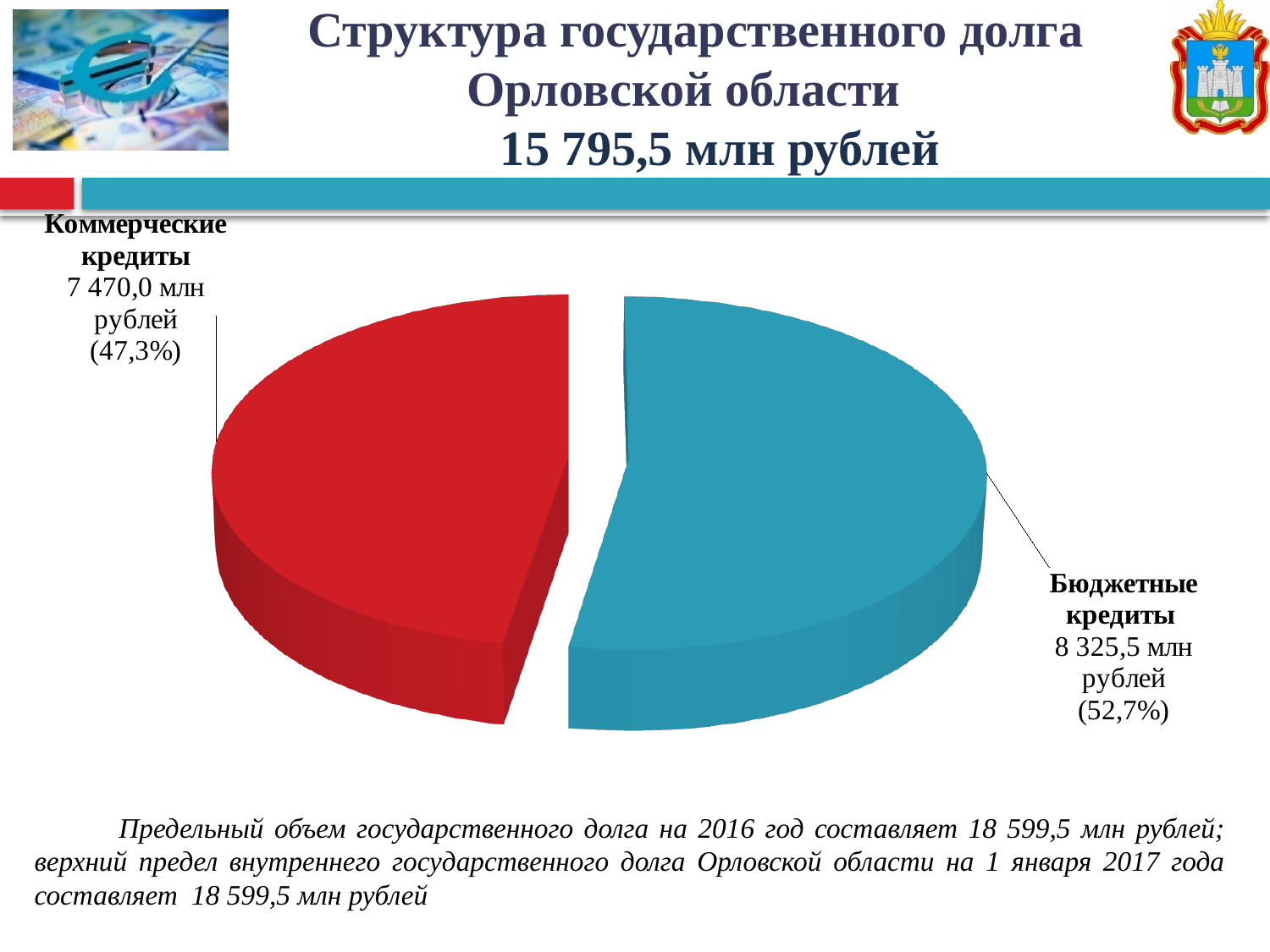
What is the difference between Бюджетные кредиты and Коммерческие кредиты in млн рублей? 855,5 млн рублей How many slices does the pie chart have? 2 Which is larger, Бюджетные кредиты or Коммерческие кредиты? Бюджетные кредиты What share of the pie is Коммерческие кредиты? 47,3% What share of the pie is Бюджетные кредиты? 52,7% Which slice is the smallest? Коммерческие кредиты What colour is the Бюджетные кредиты slice? blue Which slice is the largest? Бюджетные кредиты What is the value for Коммерческие кредиты? 7 470,0 млн рублей What is the value for Бюджетные кредиты? 8 325,5 млн рублей What kind of chart is shown on the slide? pie chart What is the total state debt shown in the chart title? 15 795,5 млн рублей